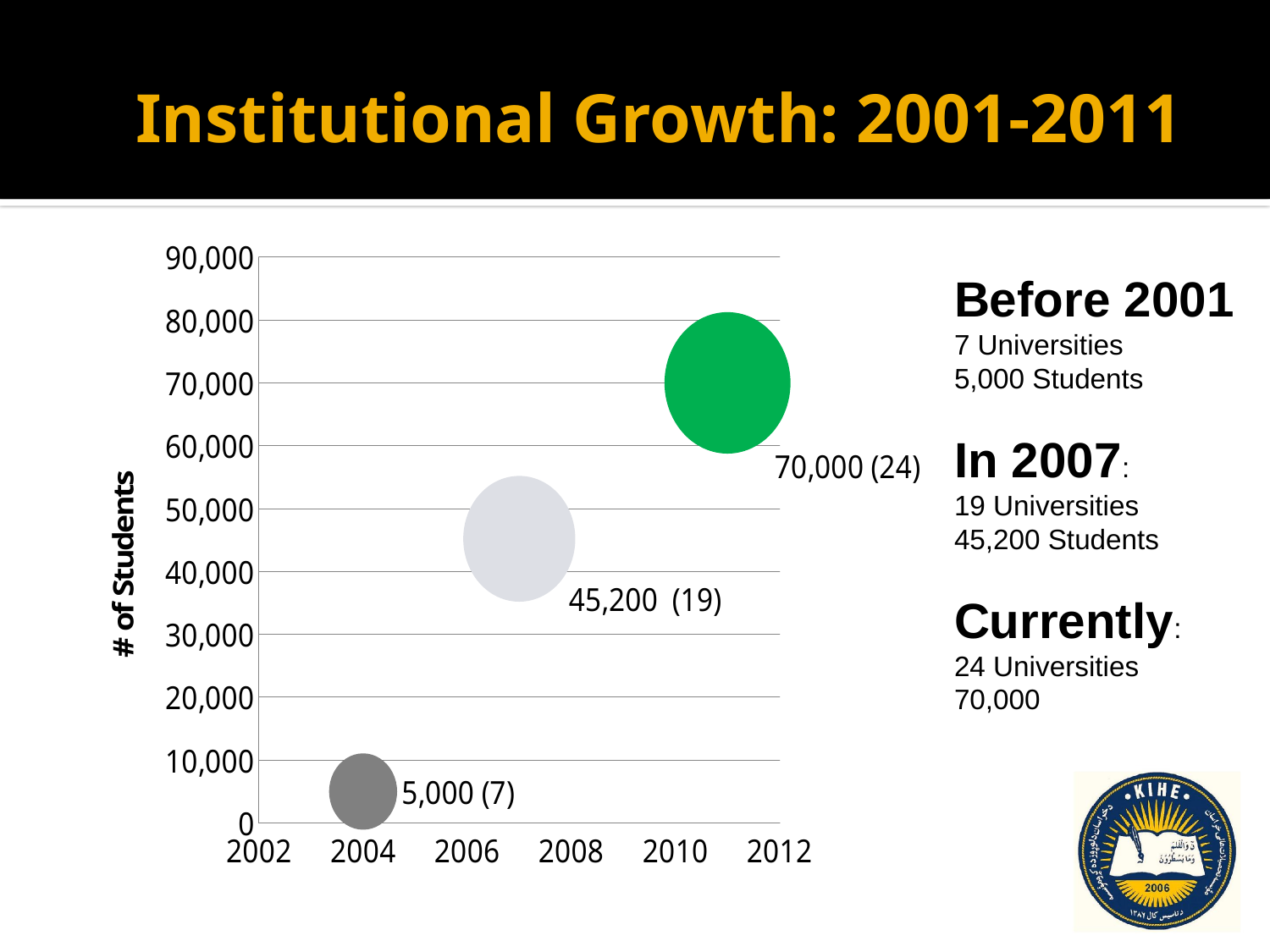
What is the difference in students between the 45,200 bubble and the 5,000 bubble? 40,200 Is the value for the green bubble greater or less than 60,000? greater What number appears in parentheses next to the leftmost (dark gray) bubble? 7 Which bubble has the lowest number of students? The dark gray (leftmost) bubble, 5,000 Do the number of students rise or fall as the years increase along the x axis? Rise What is the difference in students between the 70,000 bubble and the 45,200 bubble? 24,800 What is the title of the vertical axis? # of Students What number of students is labelled on the green (rightmost) bubble? 70,000 What number of students is labelled on the middle (light gray) bubble? 45,200 Which bubble has the highest number of students? The green (rightmost) bubble, 70,000 How many bubbles (data points) are plotted on the chart? 3 What kind of chart is shown on the slide? Bubble chart